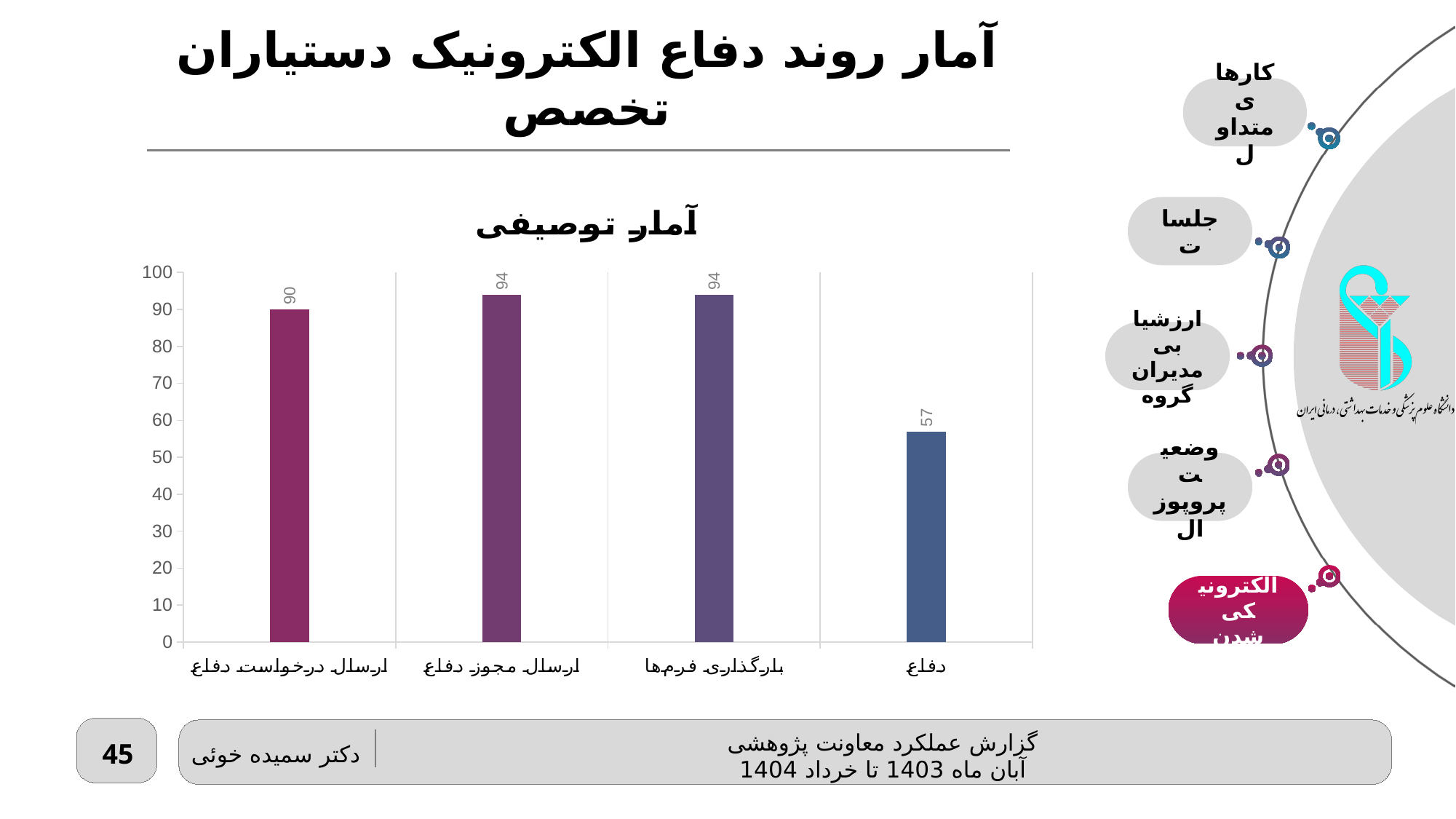
What is the value for ارسال درخواست دفاع? 90 Which category has the lowest value? دفاع Which is larger, the value for ارسال درخواست دفاع or the value for دفاع? ارسال درخواست دفاع What is the difference between the values for ارسال مجوز دفاع and دفاع? 37 What is the difference between the values for بارگذاری فرم‌ها and ارسال درخواست دفاع? 4 How many categories are shown in the chart? 4 What is the title of the chart? آمار توصیفی What is the highest value shown in the chart? 94 What is the value for دفاع? 57 What is the value for ارسال مجوز دفاع? 94 What is the value for بارگذاری فرم‌ها? 94 What kind of chart is shown on the slide? bar chart